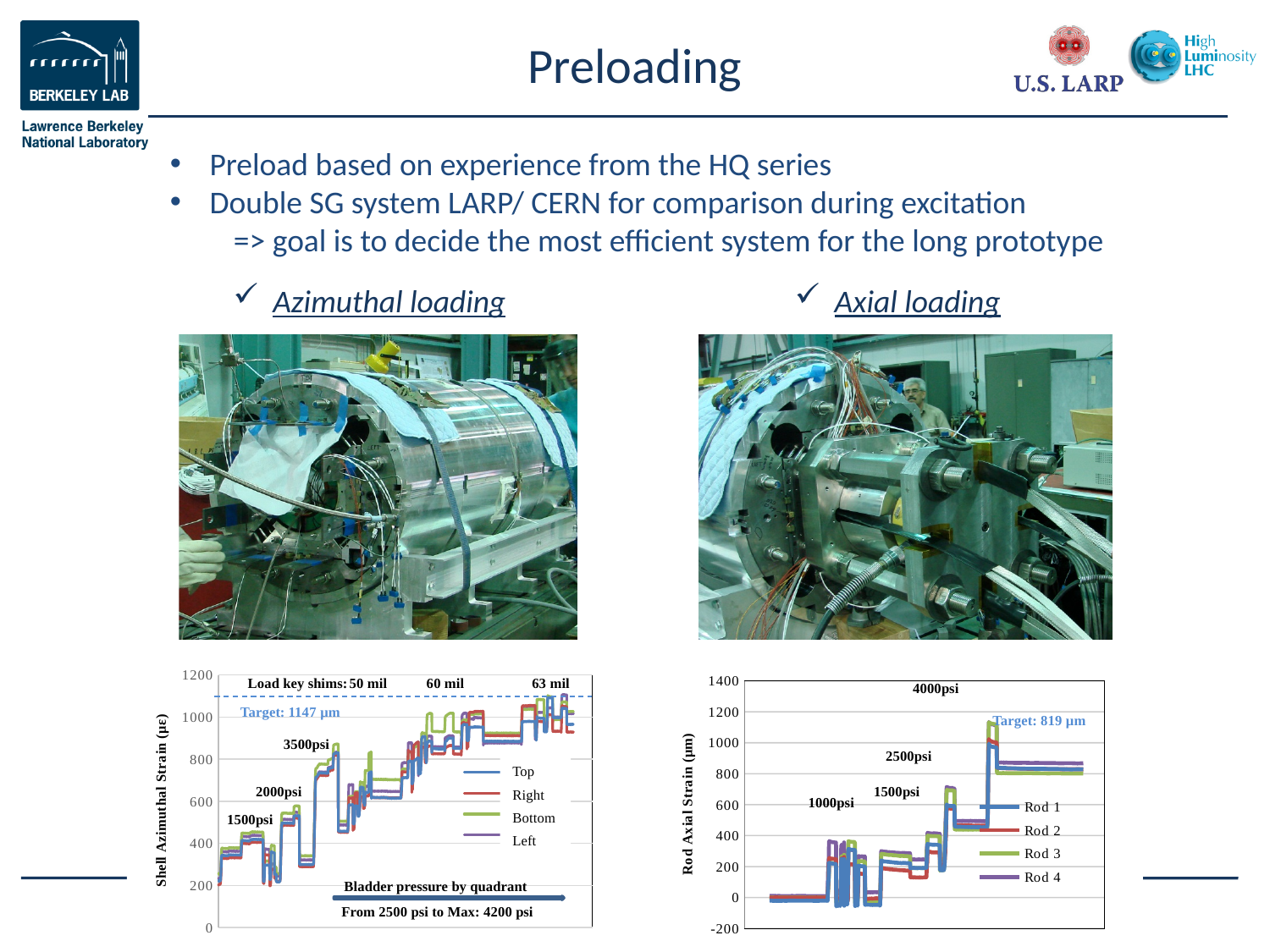
How many series does the legend of the left chart (Shell Azimuthal Strain) list? 4 What kind of chart is the right chart showing Rod Axial Strain? Line chart In the left chart (Shell Azimuthal Strain), do the strain values overall rise or fall from left to right? Rise In the right chart (Rod Axial Strain), do the strain values overall rise or fall from left to right? Rise What target value is annotated on the left chart (Shell Azimuthal Strain)? Target: 1147 µm What target value is annotated on the right chart (Rod Axial Strain)? Target: 819 µm In the left chart (Shell Azimuthal Strain), are the final strain values at the right end of the plot greater or less than 800? greater What is the highest tick value shown on the y axis of the right chart (Rod Axial Strain)? 1400 In the right chart (Rod Axial Strain), are the final strain values at the right end of the plot greater or less than 600? greater How many series does the legend of the right chart (Rod Axial Strain) list? 4 What kind of chart is the left chart showing Shell Azimuthal Strain? Line chart In the right chart (Rod Axial Strain), are the strain values at the start of the plot greater or less than 200? less